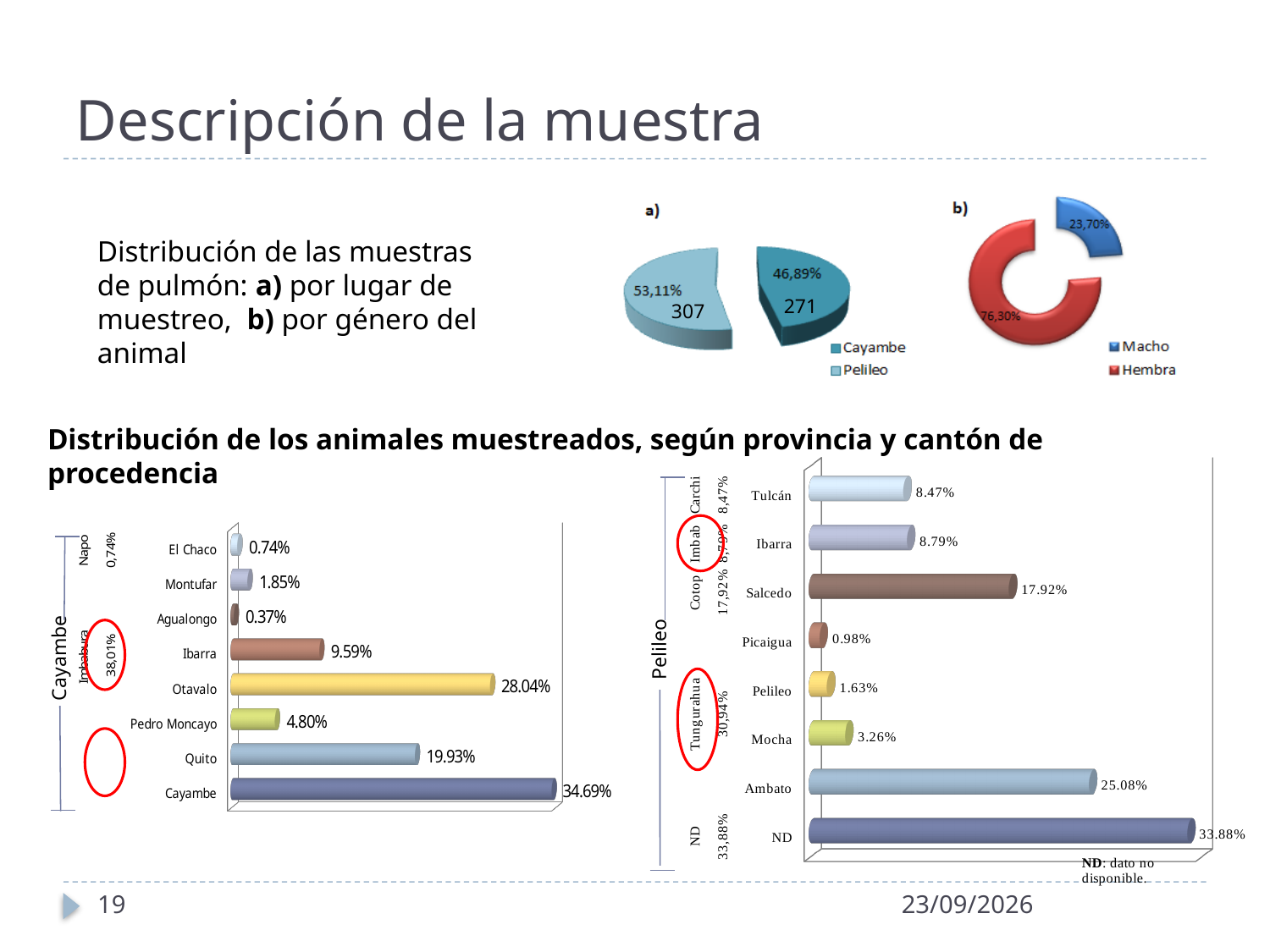
In the Cayambe bar chart (bottom left), which category has the lowest value? Agualongo In pie chart b) (by animal gender), what percentage is shown for Hembra? 76,30% In the Cayambe bar chart (bottom left), which category has the highest value? Cayambe In the Pelileo bar chart (bottom right), which category has the highest value? ND In pie chart a) (by sampling location), what percentage share does Pelileo have? 53,11% What type of chart is the Pelileo chart at the bottom right of the slide? Bar chart In pie chart a) (by sampling location), what count is shown on the Cayambe slice? 271 In pie chart b) (by animal gender), which category has the larger share, Macho or Hembra? Hembra In the Cayambe bar chart (bottom left), what is the difference between the values for Quito and Ibarra? 10.34% In the Pelileo bar chart (bottom right), what is the value for Salcedo? 17.92% In the Pelileo bar chart (bottom right), how many categories are plotted? 8 In the Cayambe bar chart (bottom left), what is the value for Otavalo? 28.04%